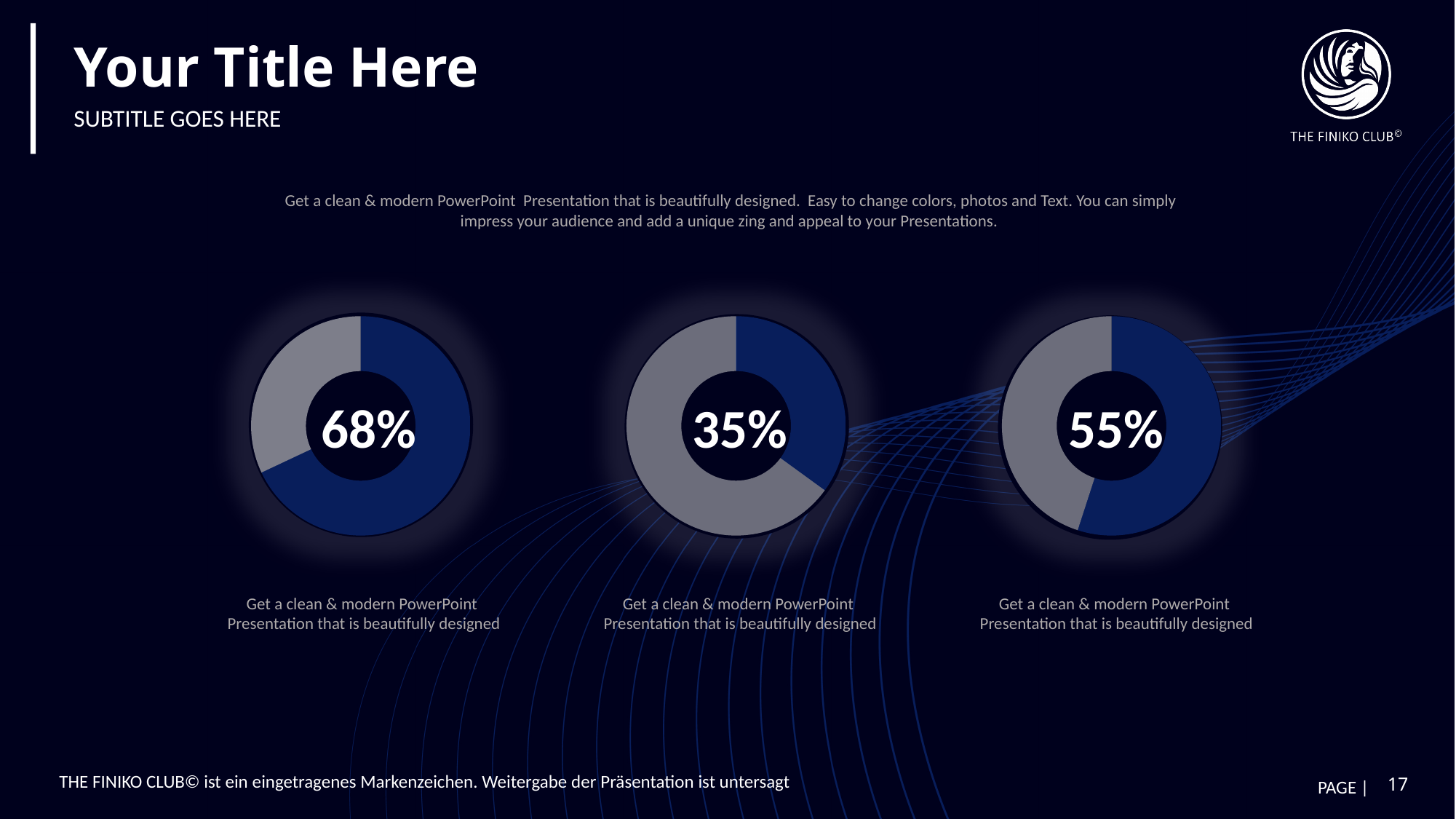
What colour is the filled (highlighted) portion of each donut chart? Blue Which of the three donut charts shows the lowest percentage? The middle chart (35%) What is the difference between the percentage in the right donut chart and the percentage in the middle donut chart? 20% What percentage is shown in the centre of the left donut chart? 68% Is the percentage shown in the middle donut chart greater or less than 50%? less What kind of chart is used to display the three percentages on the slide? Donut chart What percentage is shown in the centre of the right donut chart? 55% Which is larger, the percentage in the left donut chart or the percentage in the right donut chart? The left chart (68%) How many donut charts are shown on the slide? 3 What percentage is shown in the centre of the middle donut chart? 35% What is the difference between the percentage in the left donut chart and the percentage in the middle donut chart? 33% Which of the three donut charts shows the highest percentage? The left chart (68%)